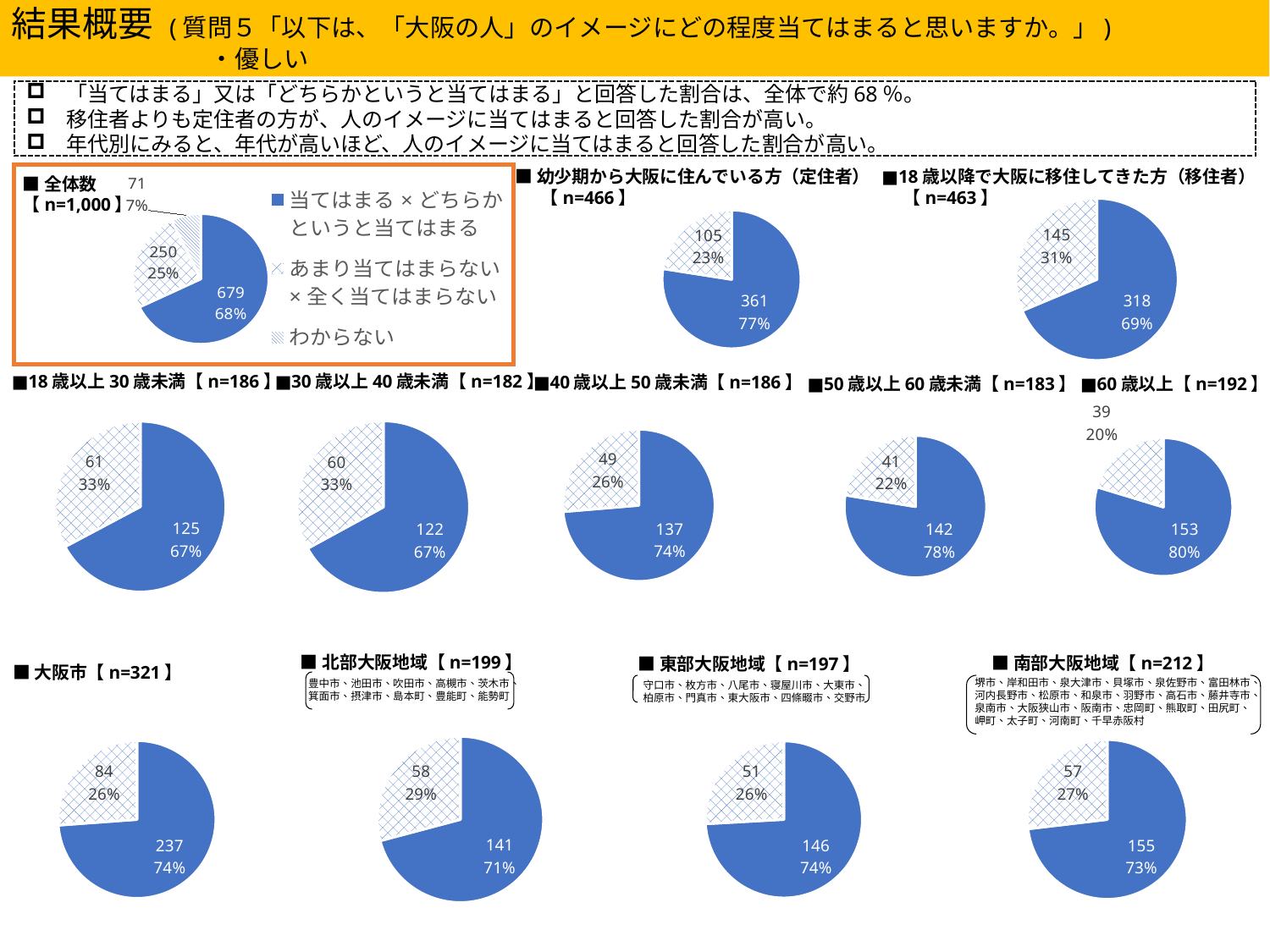
Among the five age-group pie charts (18歳以上30歳未満 to 60歳以上), which has the highest percentage for the solid blue slice? 60歳以上【n=192】 In the 大阪市【n=321】chart, what is the total of the two slices (237 and 84)? 321 In the 幼少期から大阪に住んでいる方（定住者）【n=466】chart, what percentage is shown for the solid blue slice? 77% What kind of chart is used for 幼少期から大阪に住んでいる方（定住者）【n=466】? pie chart Among the four regional charts (大阪市, 北部大阪地域, 東部大阪地域, 南部大阪地域), which has the lowest percentage for the solid blue slice? 北部大阪地域【n=199】 How many entries does the legend of the 全体数【n=1,000】chart list? 3 In the 50歳以上60歳未満【n=183】chart, what is the value of the cross-hatched slice? 41 In the 全体数【n=1,000】pie chart, what share of the pie is わからない? 7% In the 全体数【n=1,000】pie chart, what is the value for 当てはまる × どちらかというと当てはまる? 679 Which is larger: the solid blue slice in the 定住者【n=466】chart or the solid blue slice in the 移住者【n=463】chart? 定住者【n=466】 In the 18歳以降で大阪に移住してきた方（移住者）【n=463】chart, what is the value of the cross-hatched slice? 145 What is the difference between the solid blue slice values in the 定住者【n=466】chart (361) and the 移住者【n=463】chart (318)? 43